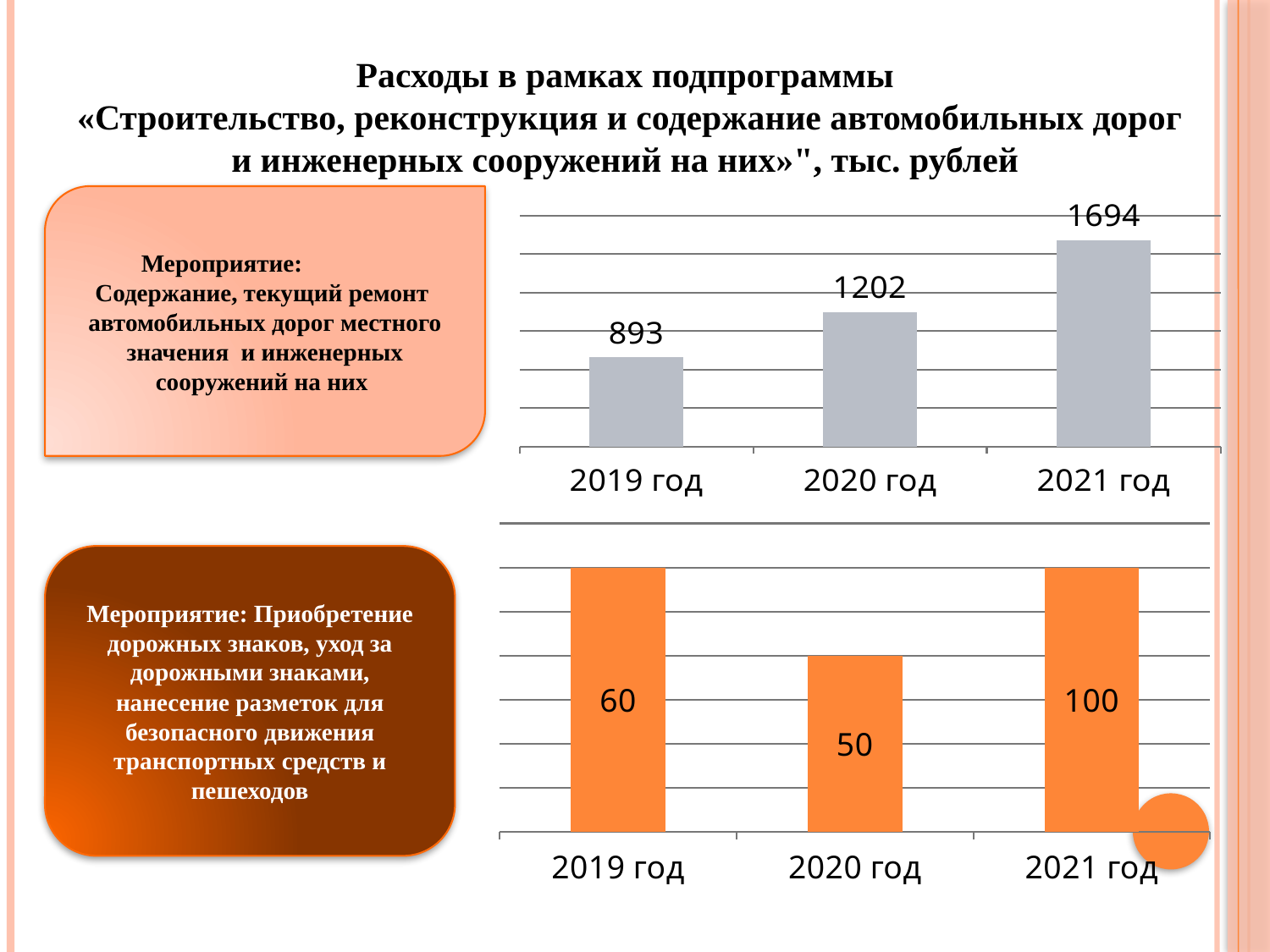
In the top chart, do the values rise or fall from 2019 год to 2021 год? rise In the bottom chart, which year has the lowest value? 2020 год In the bottom chart, what is the value for 2020 год? 50 In the bottom chart, what is the value for 2021 год? 100 In the top chart, what is the value for 2019 год? 893 In the top chart, what is the value for 2021 год? 1694 In the top chart, which year has the lowest value? 2019 год In the bottom chart, which is larger, the value for 2020 год or 2021 год? 2021 год In the top chart, which year has the highest value? 2021 год How many charts are on the slide, and what type are they? Two bar charts In the top chart, what is the difference between the values for 2021 год and 2020 год? 492 In the bottom chart, what is the difference between the values for 2019 год and 2020 год? 10